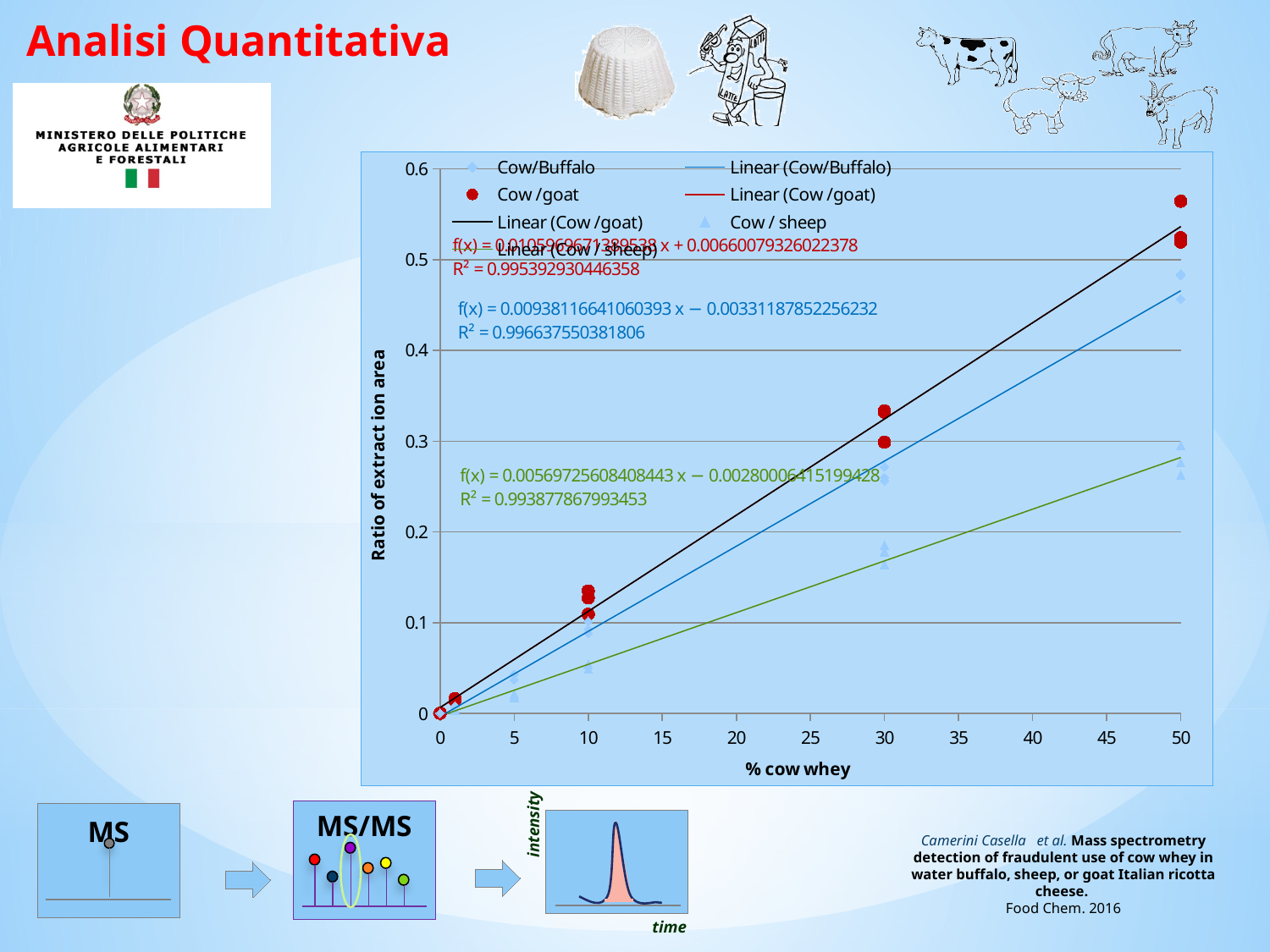
At 50% cow whey, is the Cow/goat ratio greater or less than 0.5? greater What is the R² value printed for the blue (Cow/Buffalo) trendline? 0.996637550381806 What is the label of the x axis of the chart? % cow whey At 30% cow whey, is the Cow/sheep ratio greater or less than 0.2? less What is the label of the y axis of the chart? Ratio of extract ion area How many data series (excluding the linear trendlines) are plotted in the chart? 3 Which of the three printed R² values is the lowest? 0.993877867993453 Do the plotted ratios rise or fall as % cow whey increases? rise At 50% cow whey, is the Cow/Buffalo ratio greater or less than 0.4? greater What kind of chart is shown on the slide? scatter chart At 50% cow whey, which series has the higher ratio of extract ion area: Cow/goat or Cow/sheep? Cow/goat